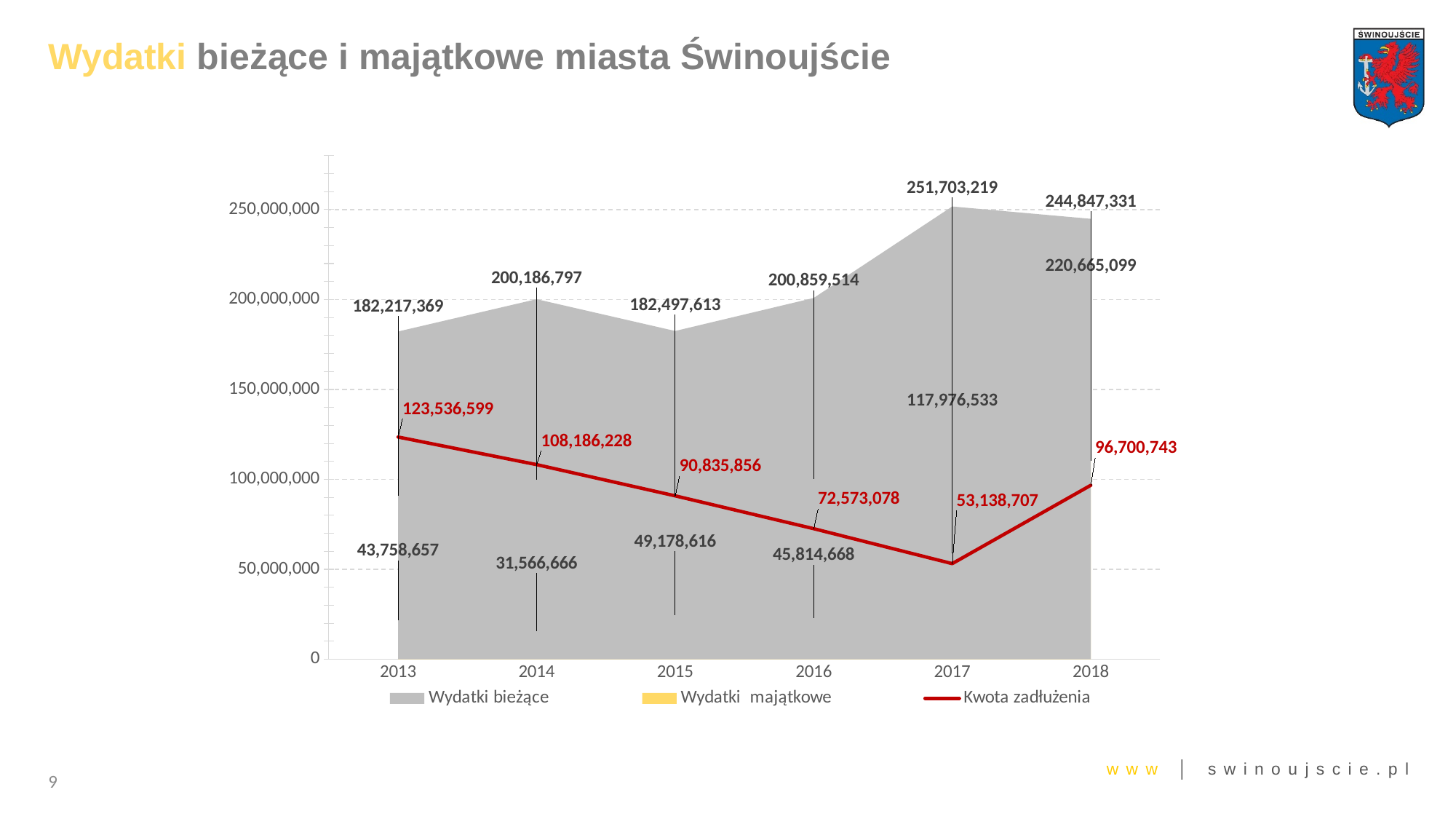
How many years are shown on the x axis? 6 Which is larger: Kwota zadłużenia in 2014 or in 2016? 2014 What is the value of Kwota zadłużenia for 2018? 96,700,743 Is the value of Wydatki bieżące for 2015 greater or less than 200,000,000? less In which year is Wydatki bieżące highest? 2017 What is the value of Kwota zadłużenia for 2013? 123,536,599 In which year is Kwota zadłużenia lowest? 2017 What is the value of Wydatki bieżące for 2017? 251,703,219 Does Kwota zadłużenia rise or fall from 2013 to 2017? fall How many series does the legend list? 3 What is the difference between Wydatki bieżące in 2017 and 2018? 6,855,888 What is the value of Wydatki bieżące for 2014? 200,186,797